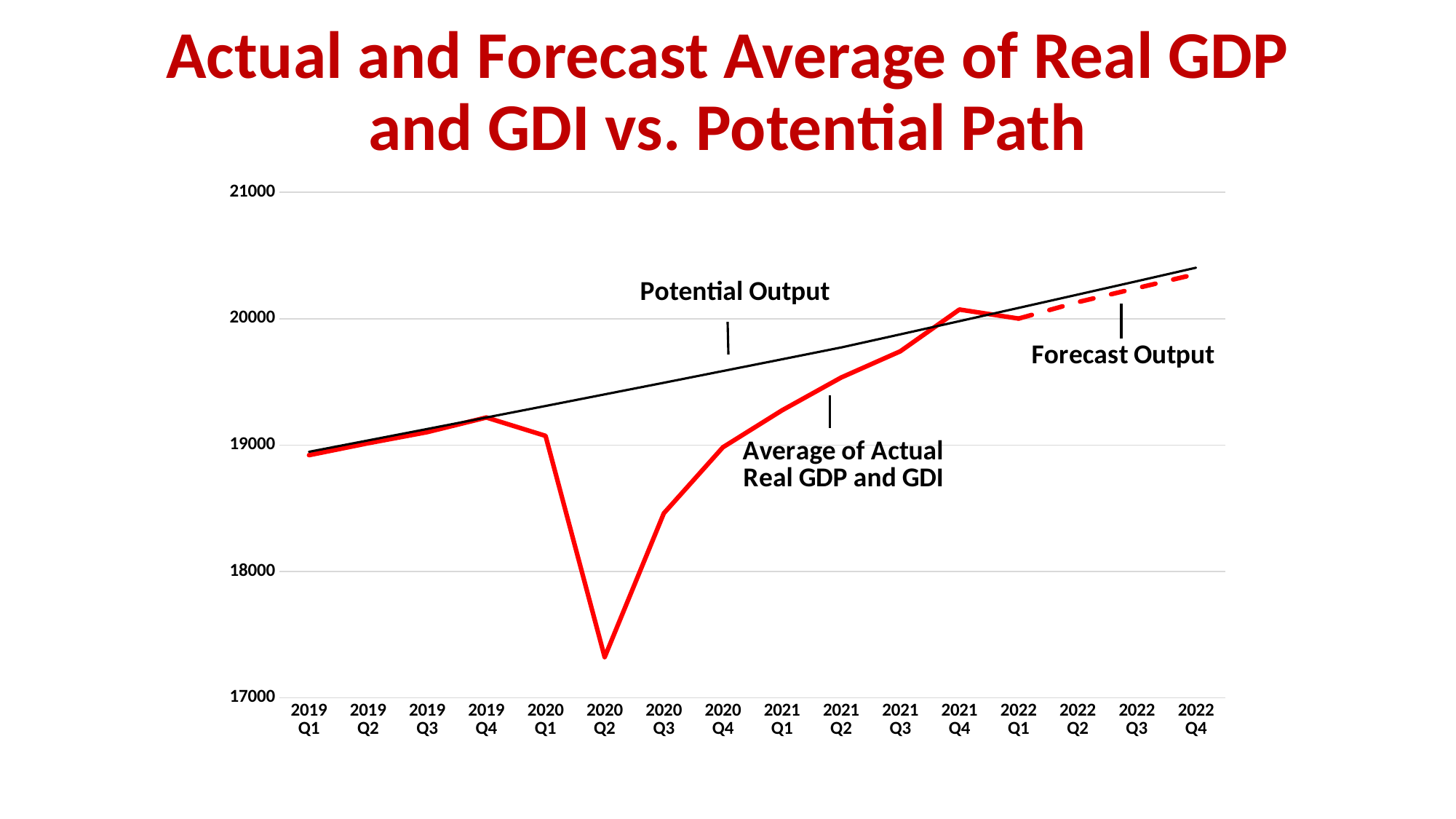
Is the value of the Average of Actual Real GDP and GDI in 2019 Q1 greater or less than 19000? less Which line on the chart is drawn as a dashed line? Forecast Output Does Potential Output rise or fall from 2019 Q1 to 2022 Q4? rise Is the value of Potential Output in 2022 Q4 greater or less than 20000? greater How many quarters are shown along the x axis? 16 In which quarter does the Average of Actual Real GDP and GDI reach its lowest point? 2020 Q2 Which is larger in 2020 Q2, Potential Output or the Average of Actual Real GDP and GDI? Potential Output Is the value of the Average of Actual Real GDP and GDI in 2020 Q3 greater or less than 18000? greater What kind of chart is shown on the slide? line chart What is the title of the chart? Actual and Forecast Average of Real GDP and GDI vs. Potential Path